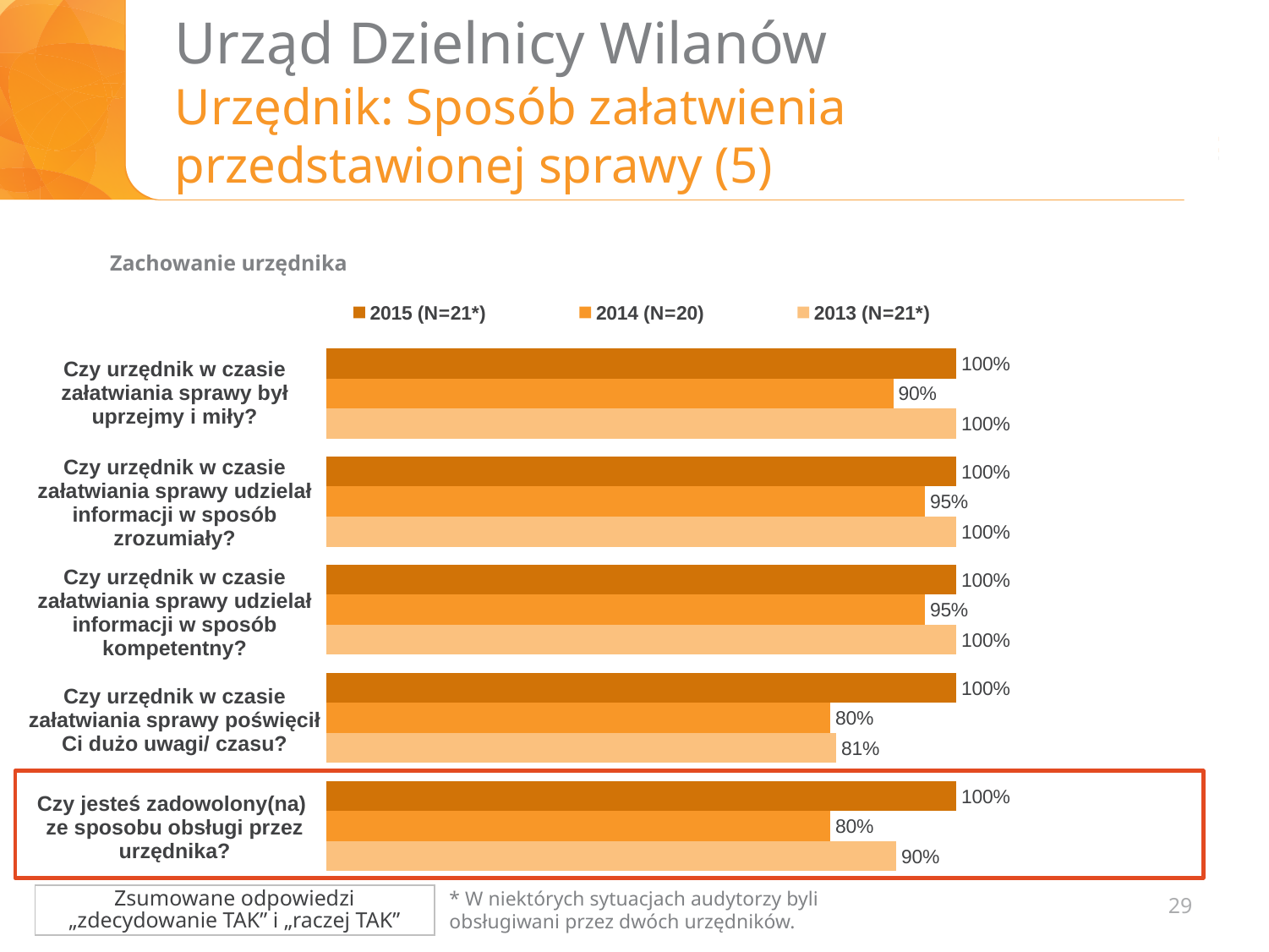
How many series does the legend list? 3 What is the 2014 (N=20) value for "Czy urzędnik w czasie załatwiania sprawy był uprzejmy i miły?"? 90% What is the 2014 (N=20) value for "Czy urzędnik w czasie załatwiania sprawy udzielał informacji w sposób kompetentny?"? 95% What is the 2015 (N=21*) value for every category on the chart? 100% What type of chart is shown on the slide? bar chart What is the 2013 (N=21*) value for "Czy jesteś zadowolony(na) ze sposobu obsługi przez urzędnika?"? 90% What is the difference between the 2015 (N=21*) and 2014 (N=20) values for "Czy jesteś zadowolony(na) ze sposobu obsługi przez urzędnika?"? 20 percentage points Which category has the lowest 2014 (N=20) value? Czy urzędnik w czasie załatwiania sprawy poświęcił Ci dużo uwagi/ czasu? and Czy jesteś zadowolony(na) ze sposobu obsługi przez urzędnika? (both 80%) What is the 2013 (N=21*) value for "Czy urzędnik w czasie załatwiania sprawy poświęcił Ci dużo uwagi/ czasu?"? 81% For "Czy urzędnik w czasie załatwiania sprawy poświęcił Ci dużo uwagi/ czasu?", which is larger: the 2014 (N=20) value or the 2013 (N=21*) value? 2013 (N=21*) How many question categories are plotted on the chart? 5 What is the title shown above the chart? Zachowanie urzędnika